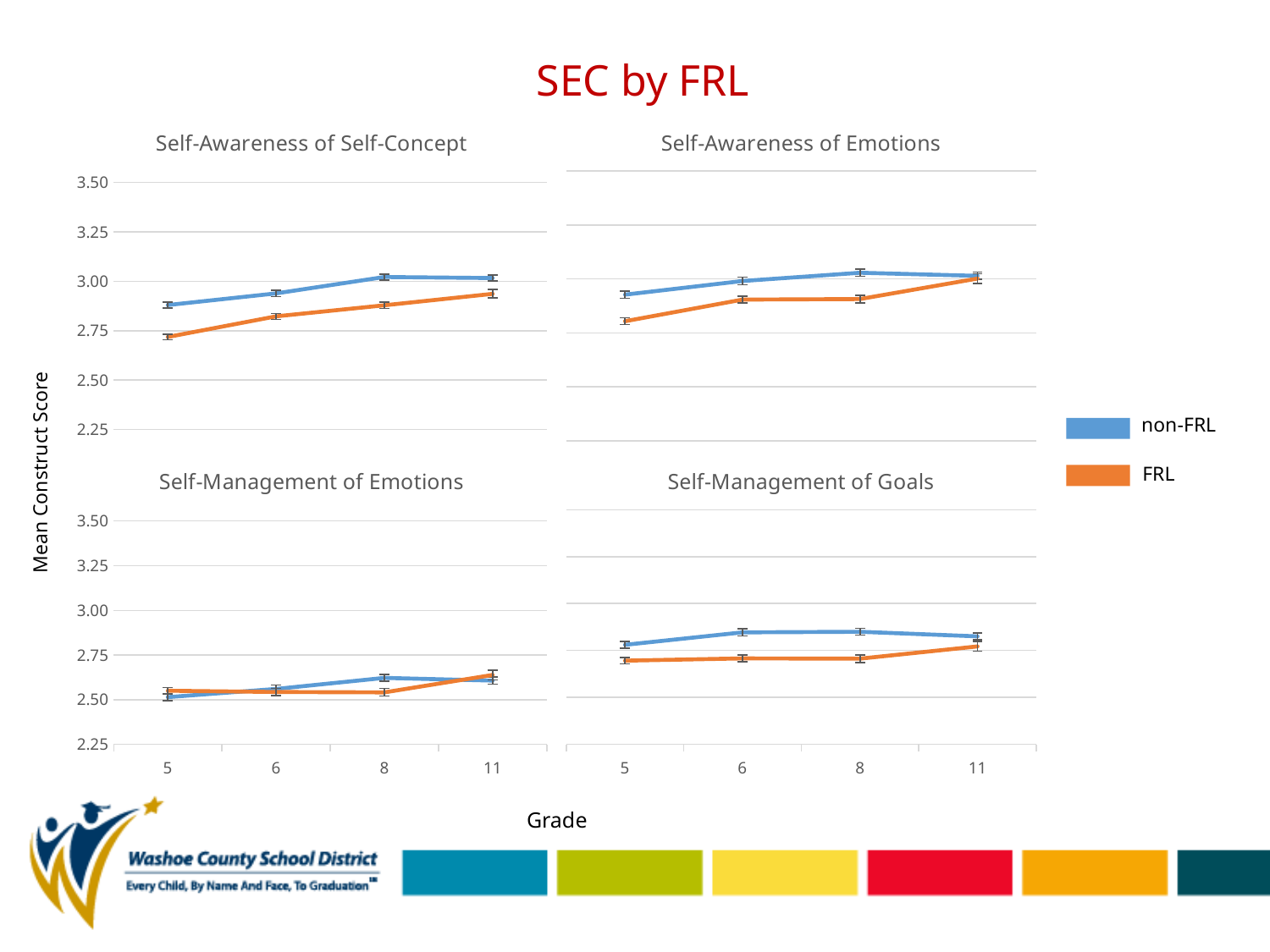
In the 'Self-Management of Goals' chart, is the non-FRL value at grade 6 greater or less than 3.00? less In the 'Self-Awareness of Self-Concept' chart, which series has the higher value at grade 5, non-FRL or FRL? non-FRL How many series does the legend list? 2 In the 'Self-Management of Goals' chart, which series has the higher value at grade 8, non-FRL or FRL? non-FRL In the 'Self-Awareness of Emotions' chart, is the FRL value at grade 8 greater or less than 3.00? less What is the label on the shared y axis of the charts? Mean Construct Score In the 'Self-Management of Goals' chart, how many grade levels are plotted along the x axis? 4 In the 'Self-Awareness of Self-Concept' chart, is the FRL value at grade 11 greater or less than 3.00? less What kind of chart is 'Self-Awareness of Self-Concept'? line chart In the 'Self-Awareness of Self-Concept' chart, does the FRL line rise or fall from grade 5 to grade 11? rise